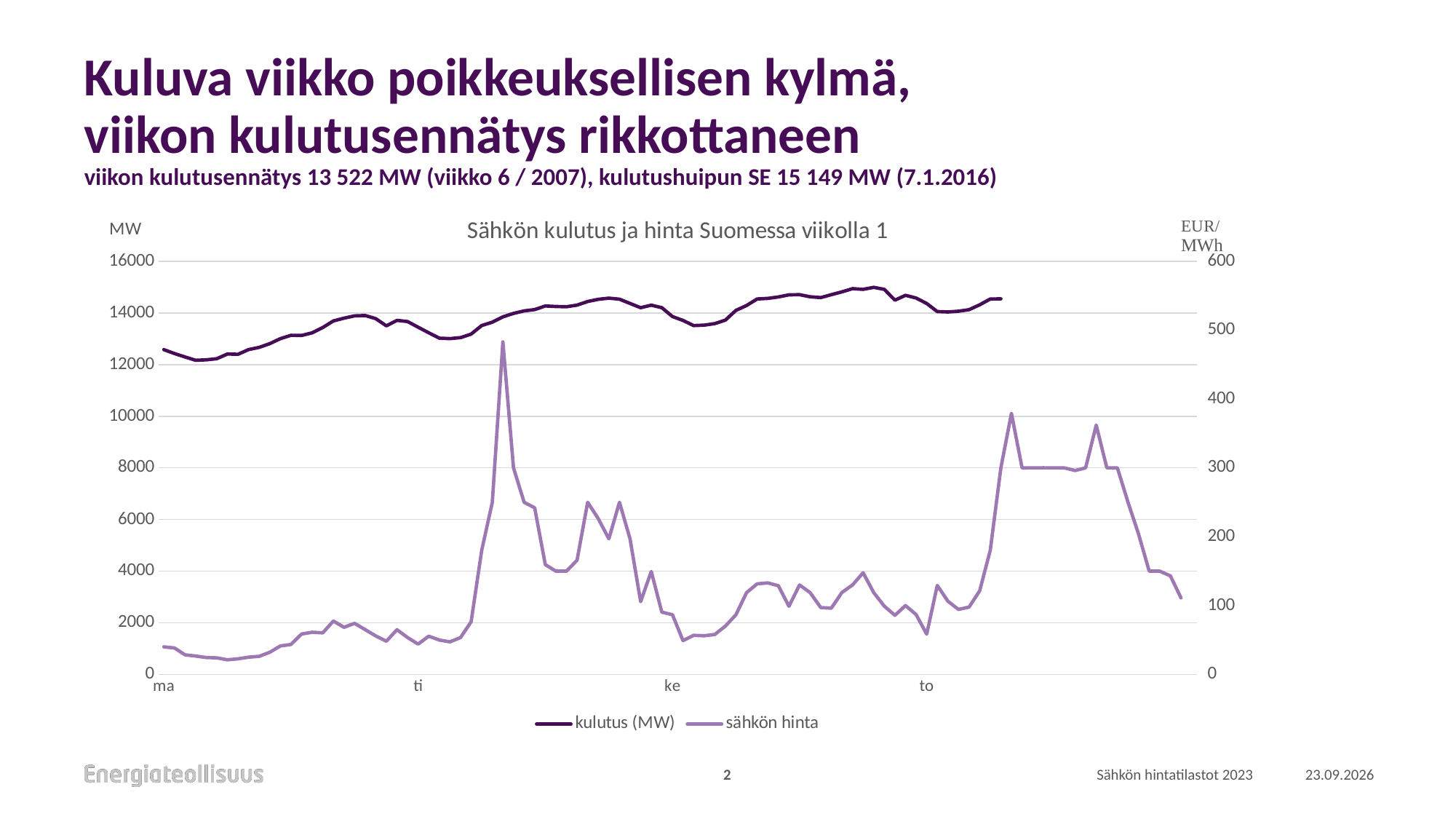
Is the highest kulutus (MW) value on the chart greater or less than 16000? less What is the title of the chart? Sähkön kulutus ja hinta Suomessa viikolla 1 How many series does the legend list? 2 How many day labels are shown on the x axis? 4 Is the peak sähkön hinta value shortly after ti greater or less than 400 EUR/MWh? greater Is the sähkön hinta value at the start of ma greater or less than 100 EUR/MWh? less What kind of chart is shown on the slide? line chart Which day label on the x axis is closest to the highest sähkön hinta peak? ti Which two series are listed in the chart legend? kulutus (MW) and sähkön hinta Does the kulutus (MW) line generally rise or fall from ma to to? rise